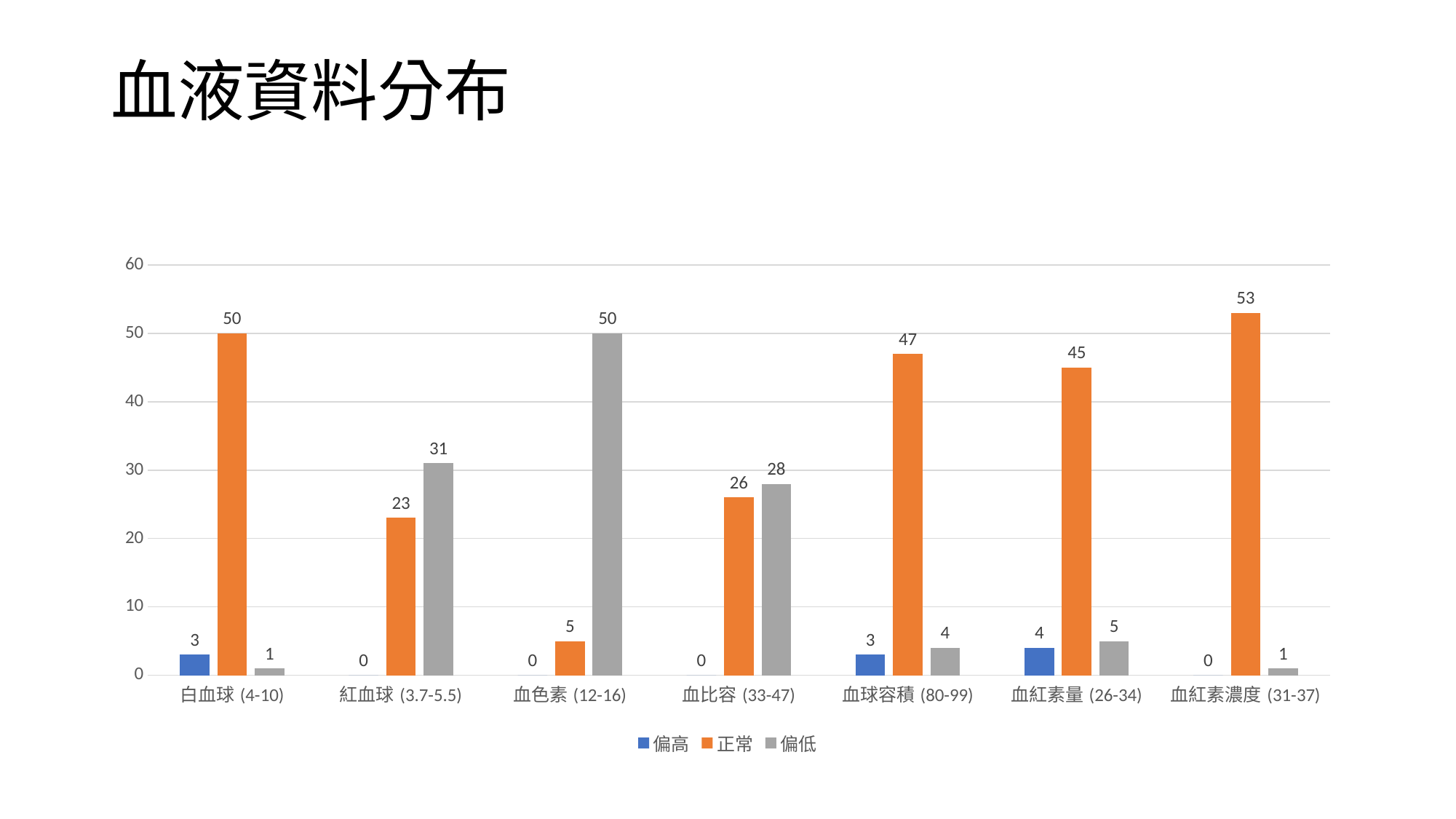
How many categories are shown on the x axis? 7 What is the 正常 value for 白血球 (4-10)? 50 Which is larger for 血比容 (33-47): the 正常 value or the 偏低 value? 偏低 What kind of chart is shown on the slide? Bar chart What is the 偏低 value for 紅血球 (3.7-5.5)? 31 What is the 偏高 value for 血紅素量 (26-34)? 4 What is the difference between the 偏低 and 正常 values for 血色素 (12-16)? 45 Which colour represents the 正常 series in the legend? Orange How many series does the legend list? 3 What is the title of the slide? 血液資料分布 Which category has the lowest 正常 value? 血色素 (12-16) Which category has the highest 正常 value? 血紅素濃度 (31-37)